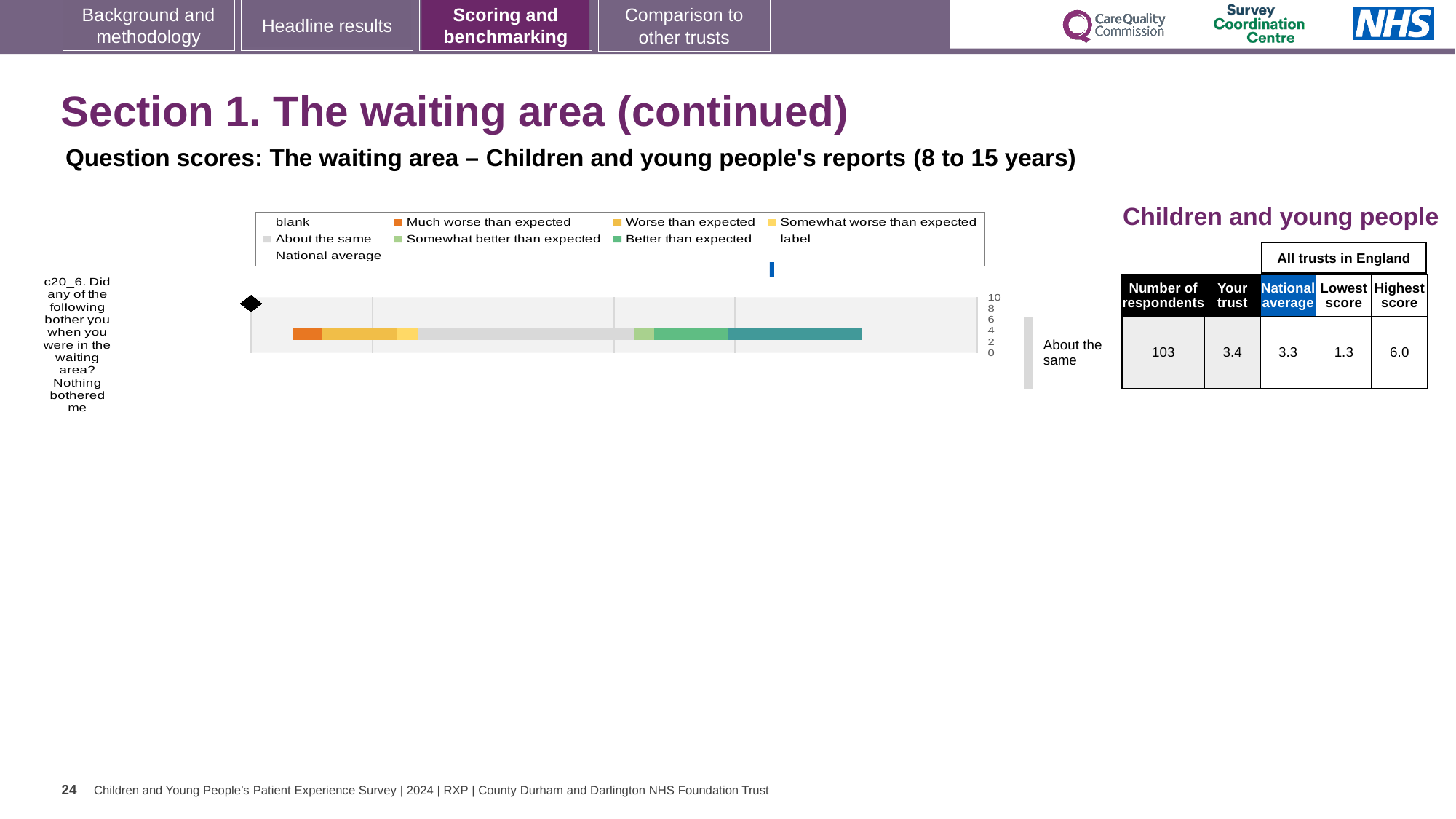
What is the difference between the highest score and the lowest score shown for question c20_6? 4.7 What colour does the legend use for 'Much worse than expected'? orange Which is larger for question c20_6, the 'Your trust' score or the national average? Your trust What is the highest score across all trusts in England shown for question c20_6? 6.0 How many entries does the chart legend list? 9 What kind of chart is shown on the slide? bar chart How many survey questions (categories) are plotted in the chart? 1 How many respondents are shown for question c20_6? 103 What is the 'Your trust' score shown for question c20_6? 3.4 What is the lowest score across all trusts in England shown for question c20_6? 1.3 What benchmark rating is shown next to the bar for question c20_6? About the same What is the national average score shown for question c20_6? 3.3